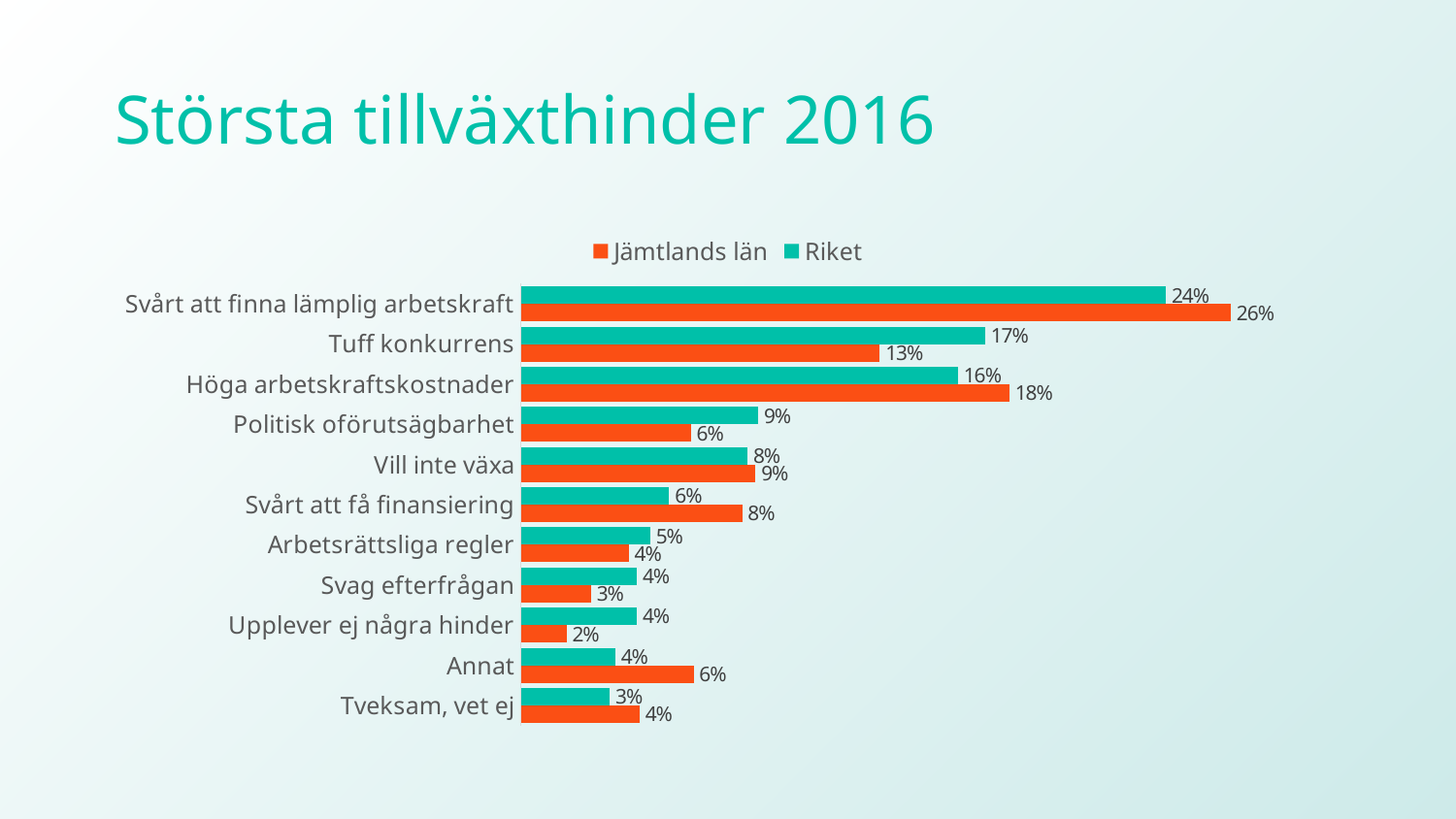
For 'Politisk oförutsägbarhet', which is larger: Jämtlands län or Riket? Riket What is the value for Jämtlands län for 'Upplever ej några hinder'? 2% What is the value for Jämtlands län for 'Svårt att finna lämplig arbetskraft'? 26% How many categories are shown in the chart? 11 Which category has the highest value for Riket? Svårt att finna lämplig arbetskraft For 'Höga arbetskraftskostnader', which is larger: Jämtlands län or Riket? Jämtlands län What is the title of the slide? Största tillväxthinder 2016 What is the value for Riket for 'Tuff konkurrens'? 17% How many series does the legend list? 2 Which category has the lowest value for Jämtlands län? Upplever ej några hinder What is the difference between Jämtlands län and Riket for 'Tuff konkurrens'? 4% What kind of chart is shown on the slide? Bar chart